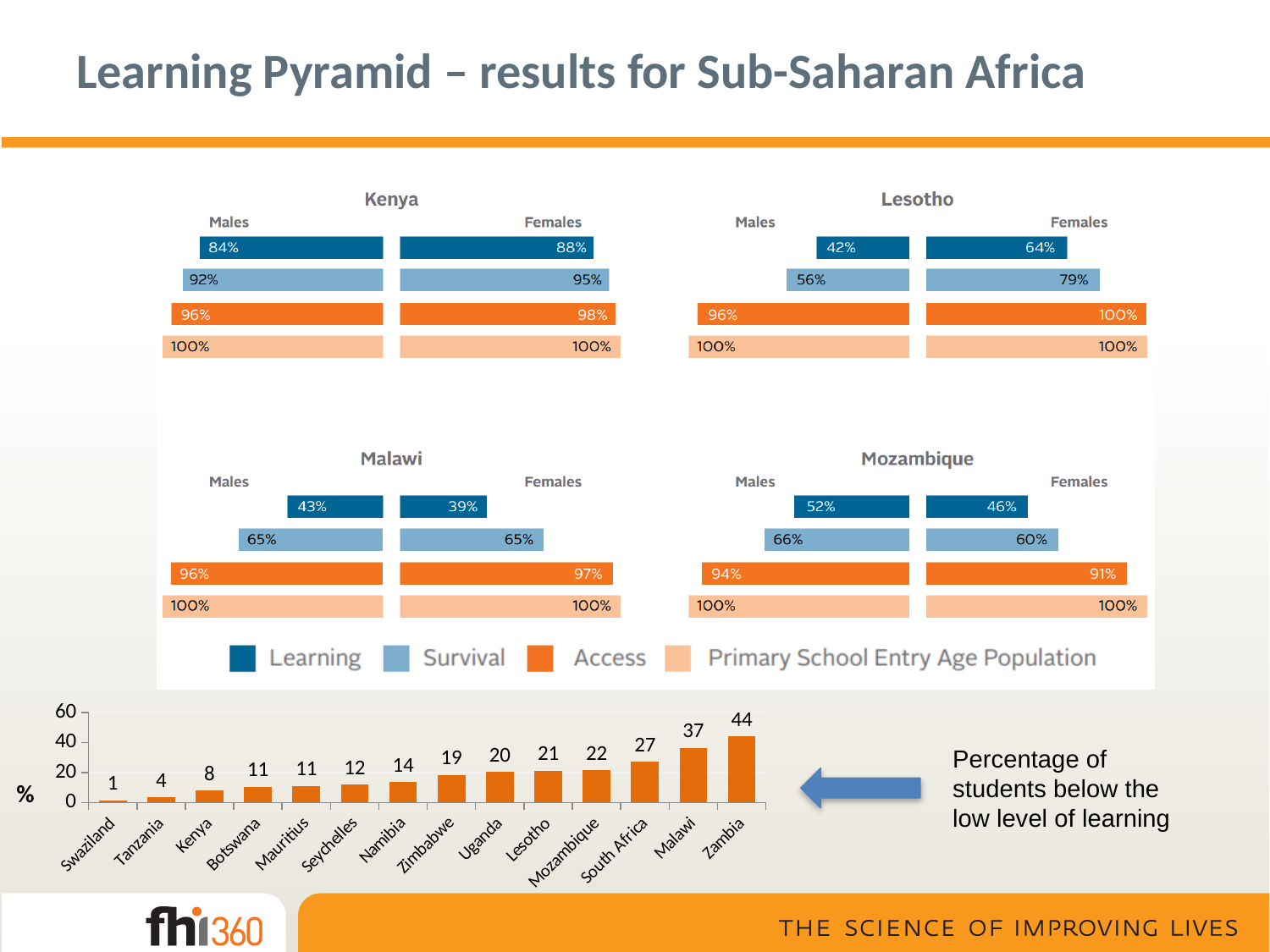
In the bottom bar chart, which country has the lowest value? Swaziland In the Kenya chart, what is the Learning value for Males? 84% In the bottom bar chart, is the value for South Africa greater or less than 20? greater In the Lesotho chart, what is the Survival value for Females? 79% How many series does the legend below the pyramid charts list? 4 In the Mozambique chart, what is the difference between the Access values for Males and Females? 3% In the bottom bar chart, which country has the highest value? Zambia In the bottom bar chart, how many countries are shown? 14 In the Malawi chart, which is larger, the Learning value for Males or for Females? Males In the bottom bar chart, do the values rise or fall from Swaziland to Zambia along the x axis? rise In the bottom bar chart, what is the value for Zambia? 44 In the bottom bar chart, what is the difference between the values for Malawi and Kenya? 29